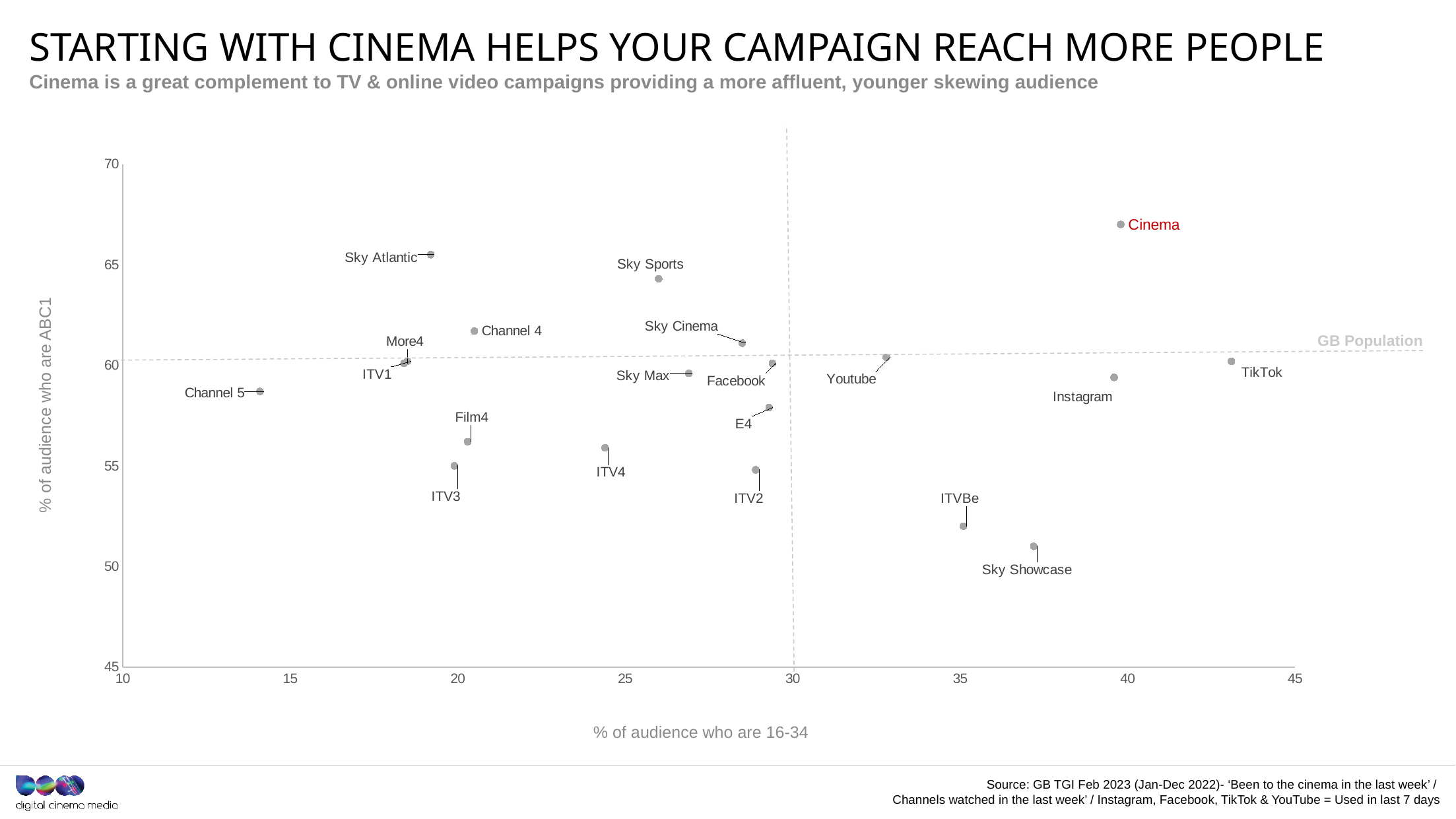
Which point on the chart is labelled in red? Cinema How many labelled points are plotted on the chart? 20 Which point has the highest % of audience who are ABC1? Cinema Which point has the lowest % of audience who are 16-34? Channel 5 Which point has the lowest % of audience who are ABC1? Sky Showcase Is the % of audience who are 16-34 for Sky Showcase greater or less than 35? greater Is the % of audience who are ABC1 for Film4 greater or less than 55? greater Which has a higher % of audience who are ABC1, Sky Atlantic or Sky Sports? Sky Atlantic Which has a higher % of audience who are 16-34, Channel 5 or TikTok? TikTok Which point has the highest % of audience who are 16-34? TikTok Is the % of audience who are ABC1 for Cinema greater or less than 65? greater What kind of chart is shown on the slide? scatter chart